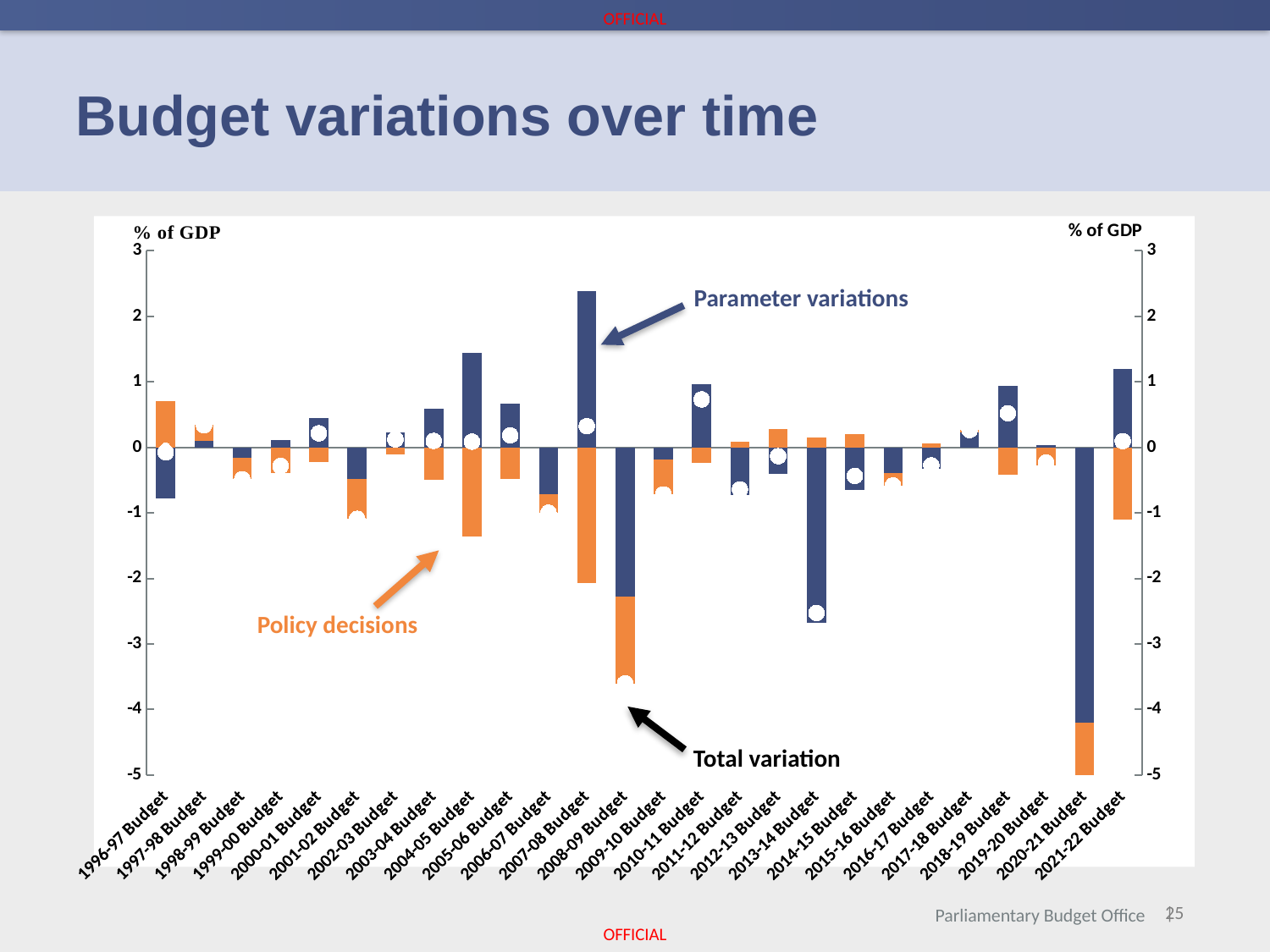
Which has the larger parameter variation, the 2007-08 Budget or the 2005-06 Budget? 2007-08 Budget What kind of chart is shown on the slide? bar chart Is the parameter variation for the 2007-08 Budget greater or less than 2? greater Which budget has the lowest total variation? 2020-21 Budget Which budget has the lowest (most negative) parameter variation? 2020-21 Budget What unit is shown on the y axis? % of GDP Which budget has the largest positive parameter variation? 2007-08 Budget Which budget has the largest positive policy decisions value? 1996-97 Budget Is the total variation for the 2009-10 Budget greater or less than -3? greater Is the parameter variation for the 2020-21 Budget greater or less than -3? less Which colour represents policy decisions? orange How many budgets are shown along the x axis? 26